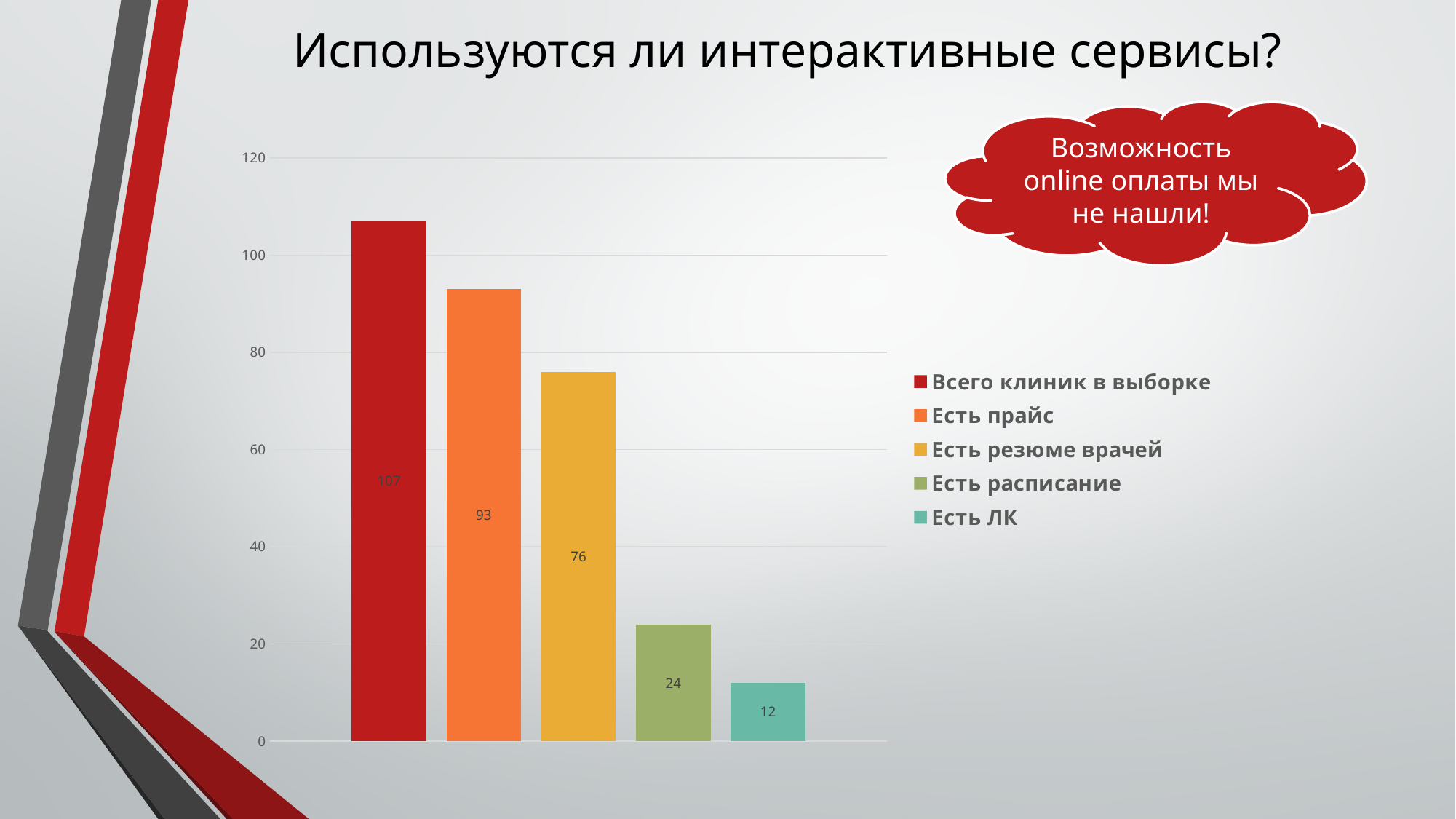
What is the difference between "Всего клиник в выборке" and "Есть прайс"? 14 What is the value for "Есть расписание"? 24 What is the value for "Всего клиник в выборке"? 107 Which is larger, "Есть резюме врачей" or "Есть расписание"? Есть резюме врачей Which series has the highest value? Всего клиник в выборке What kind of chart is shown on the slide? Bar chart What is the difference between "Есть расписание" and "Есть ЛК"? 12 What is the value for "Есть прайс"? 93 How many series does the legend list? 5 What is the value for "Есть резюме врачей"? 76 What is the value for "Есть ЛК"? 12 Which series has the lowest value? Есть ЛК